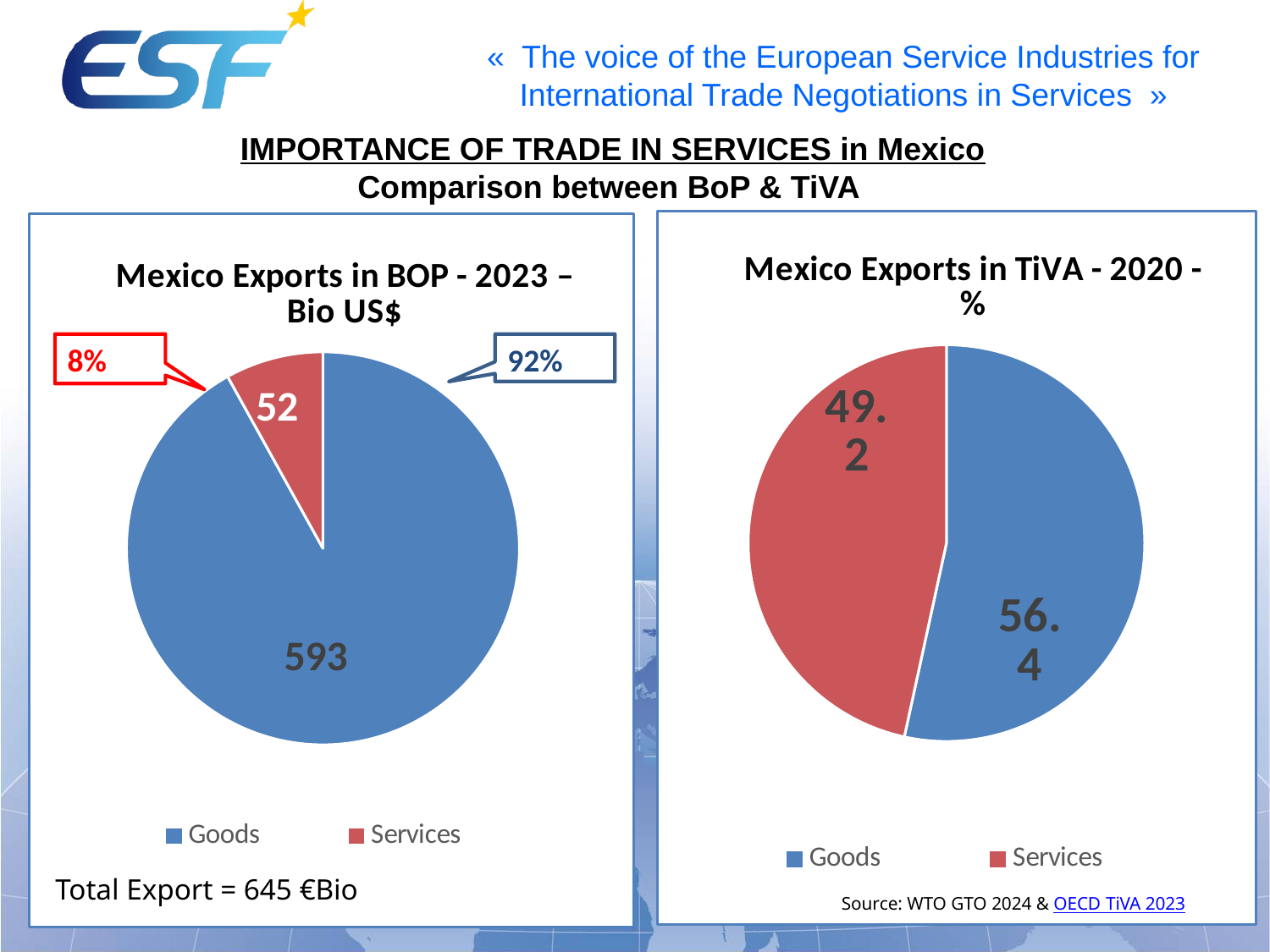
In the 'Mexico Exports in TiVA - 2020' chart, what is the value for Goods? 56.4 In the 'Mexico Exports in BOP - 2023' chart, what is the value for Services? 52 What type of chart is used on the left side of the slide for Mexico Exports in BOP? Pie chart In the 'Mexico Exports in BOP - 2023' chart, what percentage share is shown in the callout for Goods? 92% In the 'Mexico Exports in TiVA - 2020' chart, which category has the smaller value? Services How many categories does the legend of the 'Mexico Exports in TiVA - 2020' chart list? 2 What total export figure is stated below the 'Mexico Exports in BOP - 2023' chart? 645 €Bio In the 'Mexico Exports in BOP - 2023' chart, what is the difference between the Goods and Services values? 541 In the 'Mexico Exports in TiVA - 2020' chart, what is the value for Services? 49.2 In the 'Mexico Exports in BOP - 2023' chart, what percentage share is shown in the callout for Services? 8% In the 'Mexico Exports in BOP - 2023' chart, what is the value for Goods? 593 In the 'Mexico Exports in BOP - 2023' chart, which category is the largest? Goods